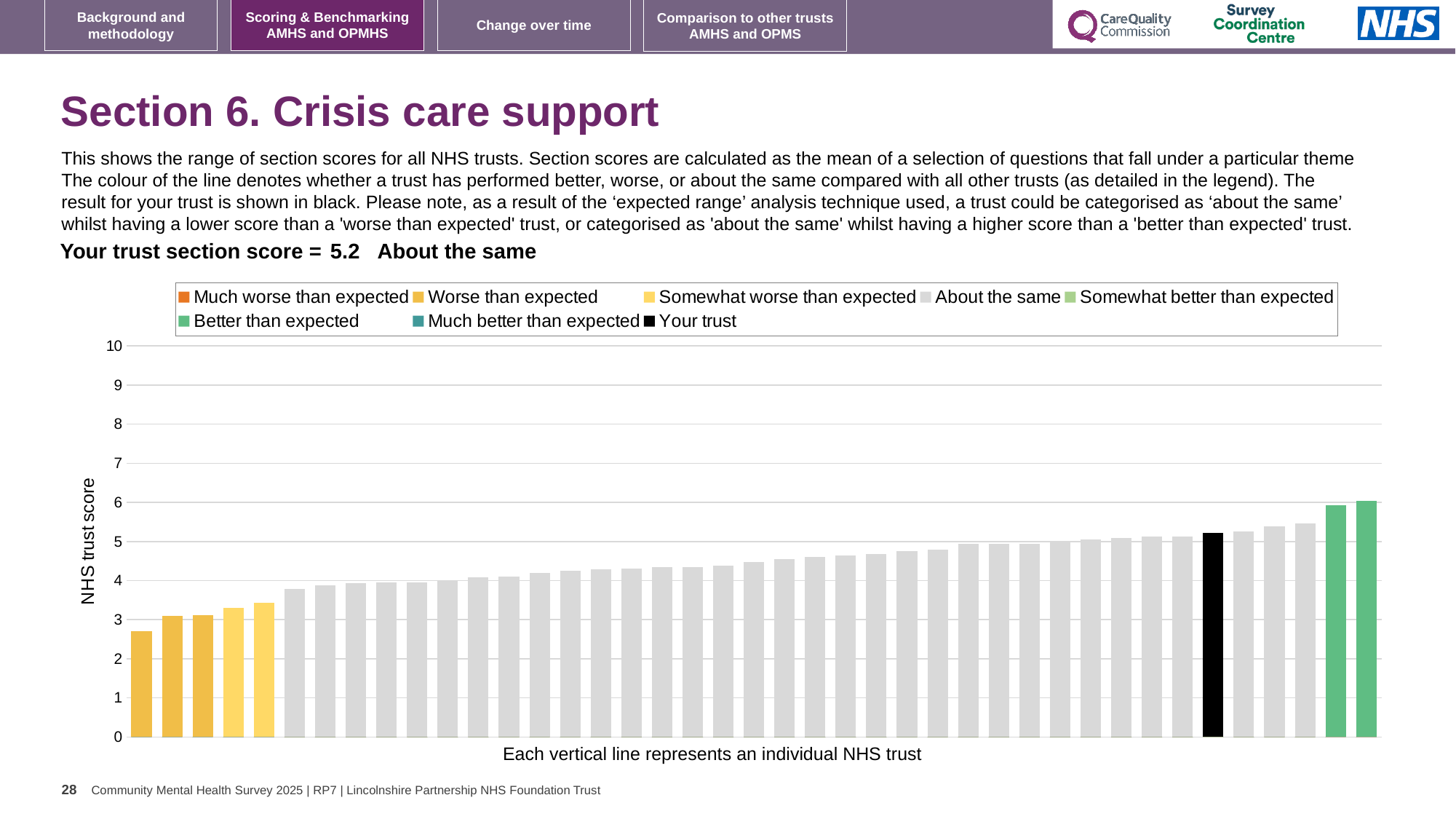
Do the bar values rise or fall from left to right along the x axis? rise Is the value of the rightmost bar greater or less than 7? less What kind of chart is shown on the slide? bar chart Which category is your trust's section score placed in? About the same What is the highest value shown on the y axis? 10 What is the title of the y axis? NHS trust score Is the value of the leftmost bar greater or less than 3? less How many bars are coloured green ('Better than expected')? 2 Is the value of the black 'Your trust' bar greater or less than 5? greater What is the section score for your trust shown on the slide? 5.2 How many entries does the chart legend list? 8